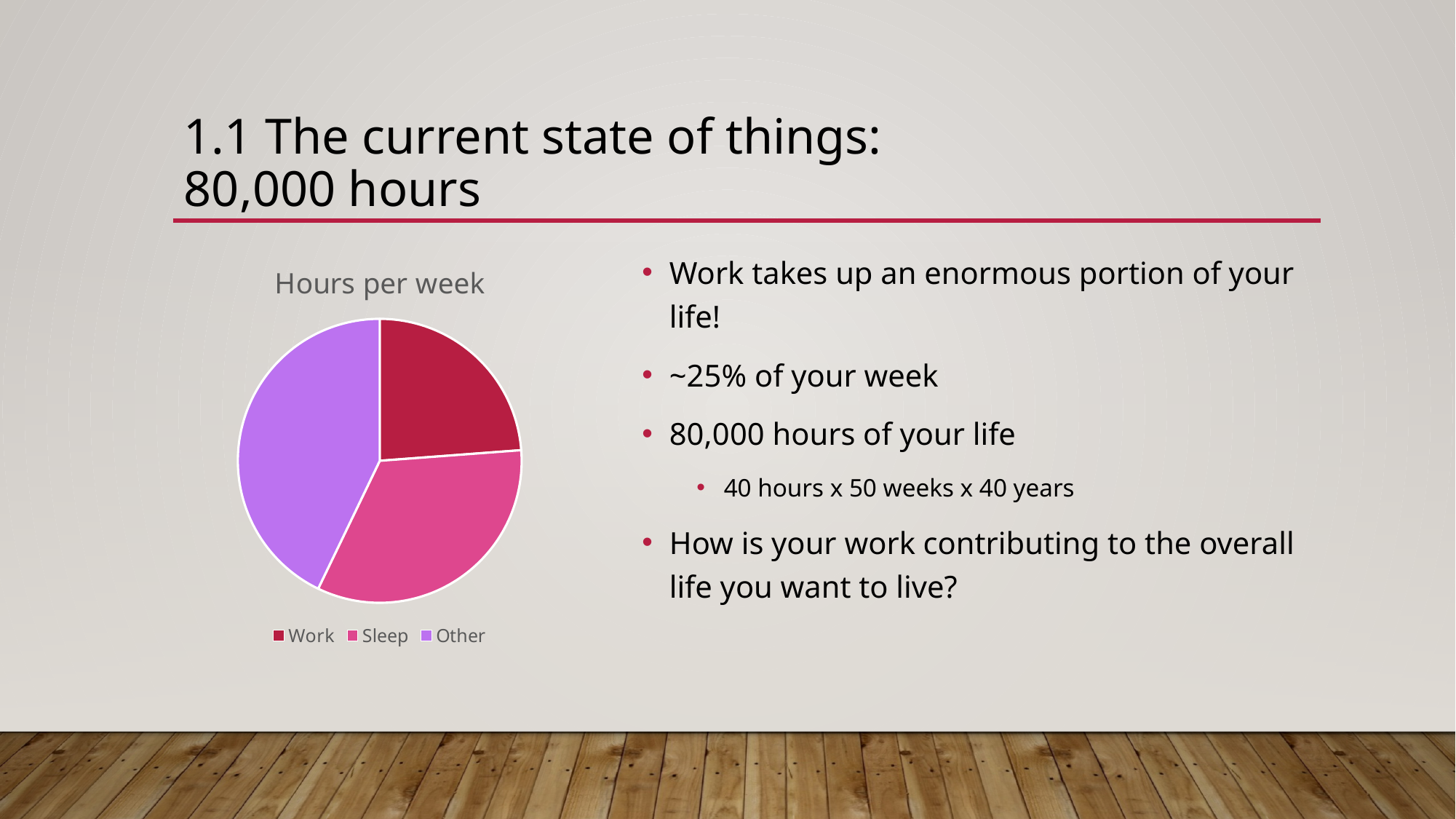
Which slice is larger, Work or Other? Other Which category has the largest slice of the pie? Other What is the title of the chart? Hours per week Which category has the smallest slice of the pie? Work Which slice is larger, Work or Sleep? Sleep Which slice is larger, Sleep or Other? Other Which category is shown in purple in the pie chart? Other What kind of chart is shown on the slide? pie chart How many slices does the pie chart have? 3 How many entries does the chart legend list? 3